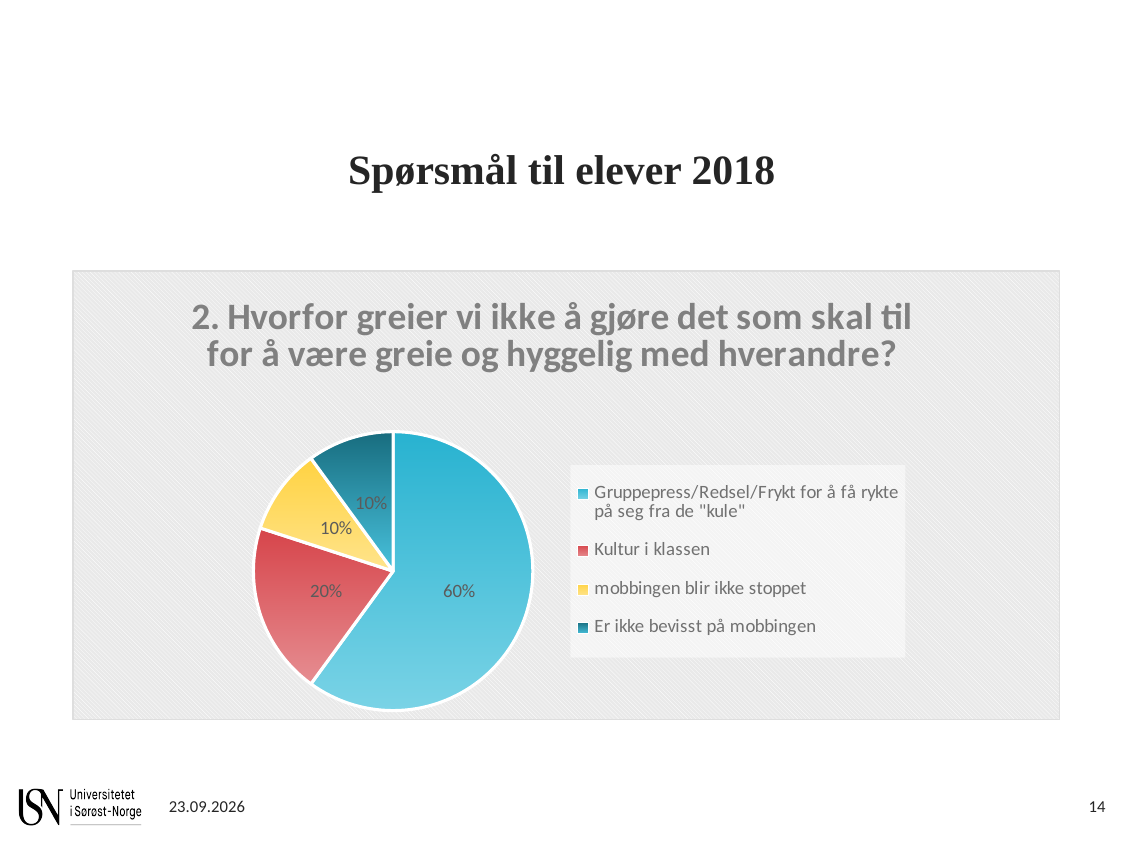
Which is larger: the slice for "Kultur i klassen" or the slice for "mobbingen blir ikke stoppet"? Kultur i klassen What share of the pie does "Er ikke bevisst på mobbingen" have? 10% How many entries does the legend list? 4 What kind of chart is shown on the slide? pie chart What is the difference in percentage points between "Gruppepress/Redsel/Frykt for å få rykte på seg fra de "kule"" and "Kultur i klassen"? 40 percentage points What share of the pie does "mobbingen blir ikke stoppet" have? 10% Which category has the largest slice of the pie? Gruppepress/Redsel/Frykt for å få rykte på seg fra de "kule" What share of the pie does "Gruppepress/Redsel/Frykt for å få rykte på seg fra de "kule"" have? 60% What is the title of the pie chart? 2. Hvorfor greier vi ikke å gjøre det som skal til for å være greie og hyggelig med hverandre? What colour is the slice for "Kultur i klassen"? red What share of the pie does "Kultur i klassen" have? 20% How many slices does the pie chart have? 4